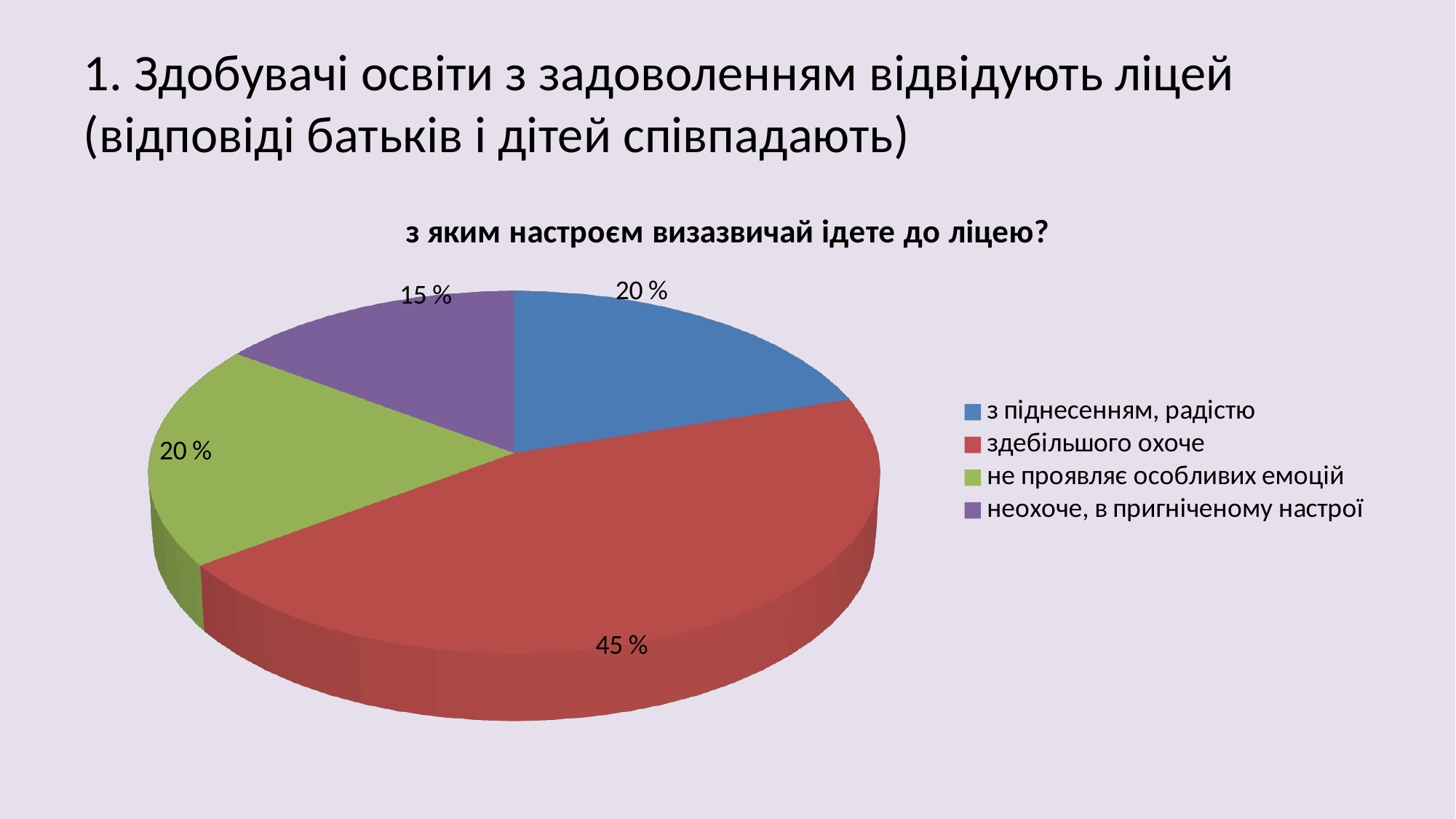
What value is shown for "не проявляє особливих емоцій"? 20 % Which category has the largest slice of the pie? здебільшого охоче What is the difference between the values for "здебільшого охоче" and "неохоче, в пригніченому настрої"? 30 % How many slices does the pie chart have? 4 Which category has the smallest slice of the pie? неохоче, в пригніченому настрої Which colour represents "не проявляє особливих емоцій" in the legend? green What kind of chart is shown on the slide? pie chart What is the title of the chart? з яким настроєм визазвичай ідете до ліцею? What value is shown for "з піднесенням, радістю"? 20 % Which is larger: the slice for "здебільшого охоче" or the slice for "з піднесенням, радістю"? здебільшого охоче What share of the pie is labelled "здебільшого охоче"? 45 % What value is shown for "неохоче, в пригніченому настрої"? 15 %